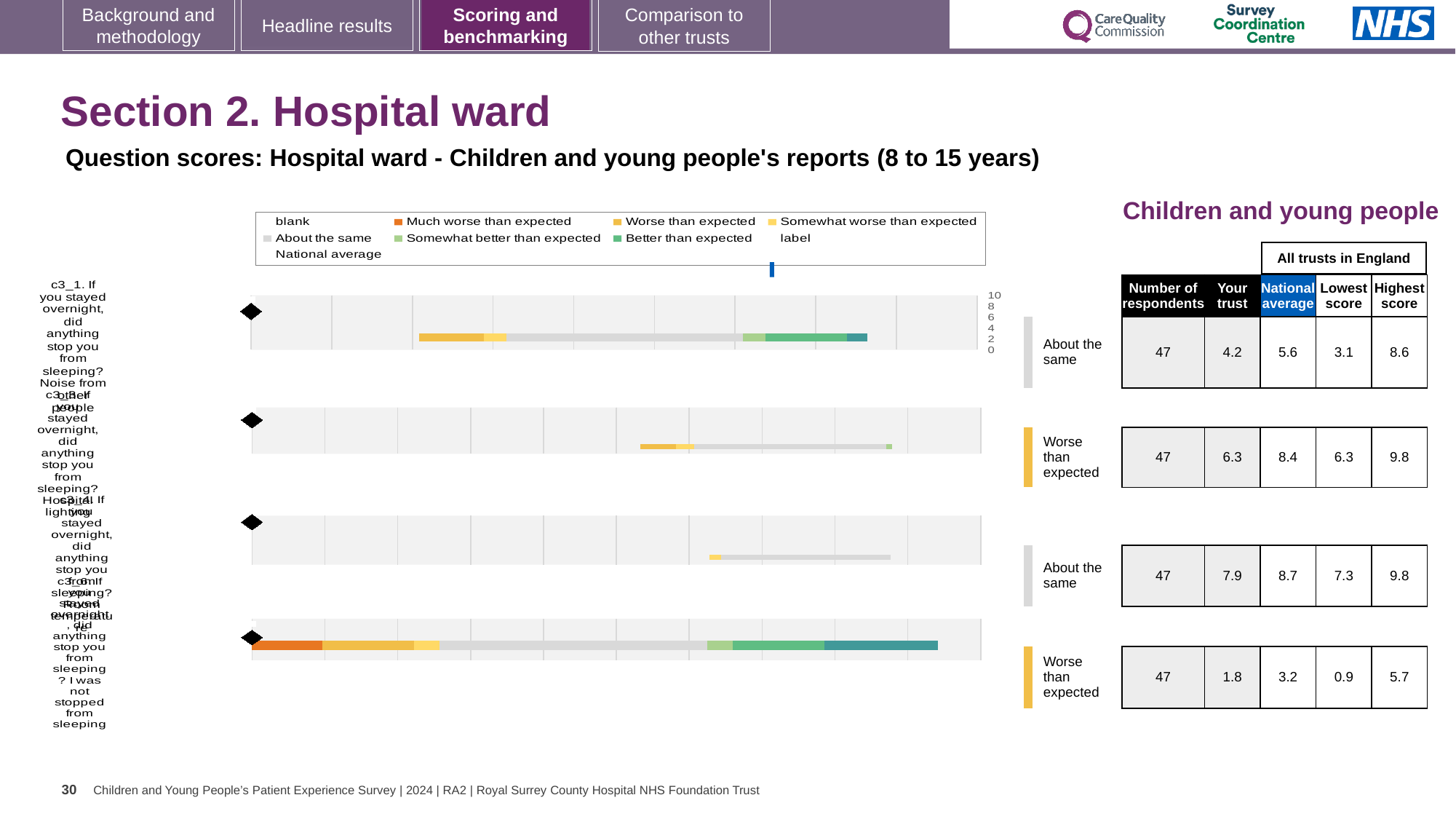
What kind of chart is used to show the question scores on this slide? bar chart What is the highest score across all trusts in England for the fourth row (c3_6, I was not stopped from sleeping)? 5.7 What benchmark category is shown for the fourth row (c3_6)? Worse than expected What is the lowest score across all trusts in England for the first row (c3_1)? 3.1 How many question rows are plotted in the chart? 4 What is the lowest 'Your trust' score among the four rows? 1.8 How many respondents are shown for question c3_1 (anything stop you from sleeping - noise from other people)? 47 For the first row (c3_1), what is the difference between the national average and the 'Your trust' score? 1.4 For the second row (c3_3), is the 'Your trust' score higher or lower than the national average? lower What is the highest 'Your trust' score among the four rows? 7.9